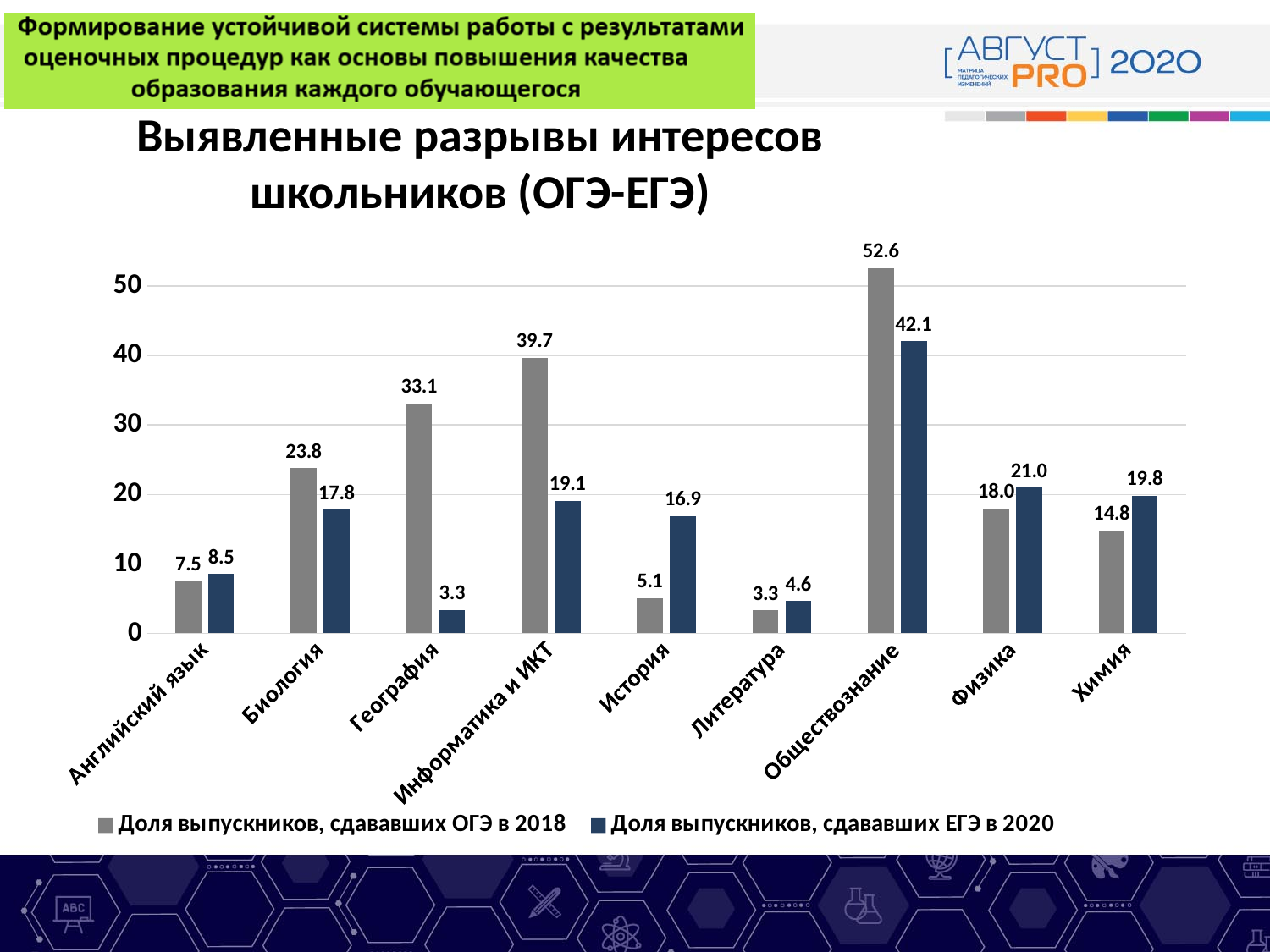
What is the title of the chart? Выявленные разрывы интересов школьников (ОГЭ-ЕГЭ) What is the difference between the 2018 ОГЭ value and the 2020 ЕГЭ value for Информатика и ИКТ? 20.6 How many subject categories are shown on the x axis? 9 How many series does the legend list? 2 What is the value for История in the series 'Доля выпускников, сдававших ЕГЭ в 2020'? 16.9 Which category has the highest value in the series 'Доля выпускников, сдававших ОГЭ в 2018'? Обществознание What kind of chart is shown on the slide? bar chart What is the value for Обществознание in the series 'Доля выпускников, сдававших ОГЭ в 2018'? 52.6 For Физика, which is larger: the 2018 ОГЭ value or the 2020 ЕГЭ value? Доля выпускников, сдававших ЕГЭ в 2020 Which category has the lowest value in the series 'Доля выпускников, сдававших ЕГЭ в 2020'? География What is the value for География in the series 'Доля выпускников, сдававших ЕГЭ в 2020'? 3.3 Is the 2018 ОГЭ value for Биология greater or less than 20? greater